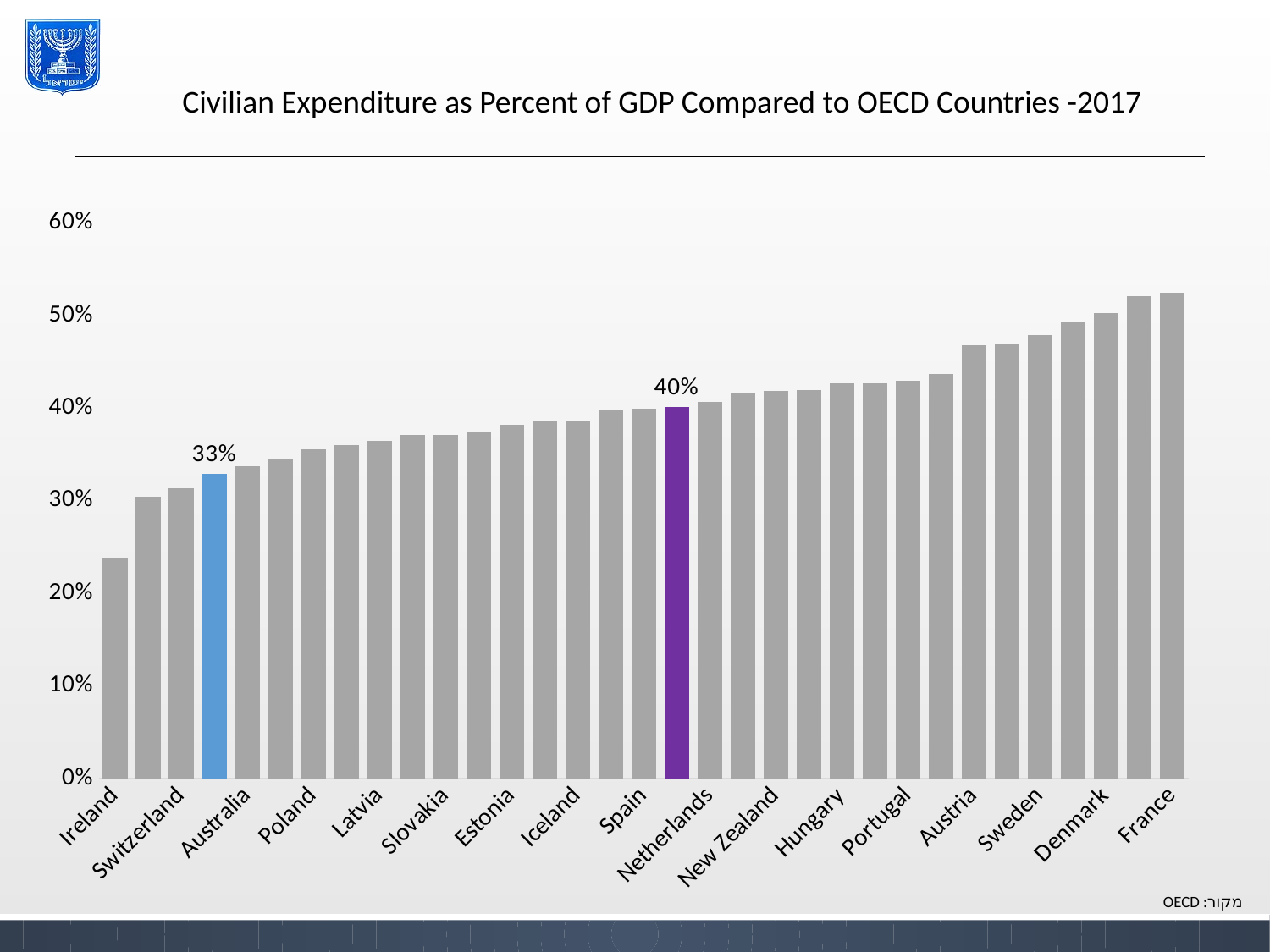
What kind of chart is shown on the slide? bar chart What is the title of the chart? Civilian Expenditure as Percent of GDP Compared to OECD Countries -2017 What value is labelled on the purple highlighted bar? 40% Is the value for France greater or less than 50%? greater Is the value for Ireland greater or less than 30%? less Which country has the lowest civilian expenditure as percent of GDP in the chart? Ireland What value is labelled on the blue highlighted bar? 33% What is the difference between the purple bar's value (40%) and the blue bar's value (33%)? 7 percentage points Do the bar values rise or fall from left to right along the x axis? rise Which country has the highest civilian expenditure as percent of GDP in the chart? France How many bars are highlighted in a colour other than grey? 2 Which is larger, the value of the blue bar or the value of the purple bar? the purple bar